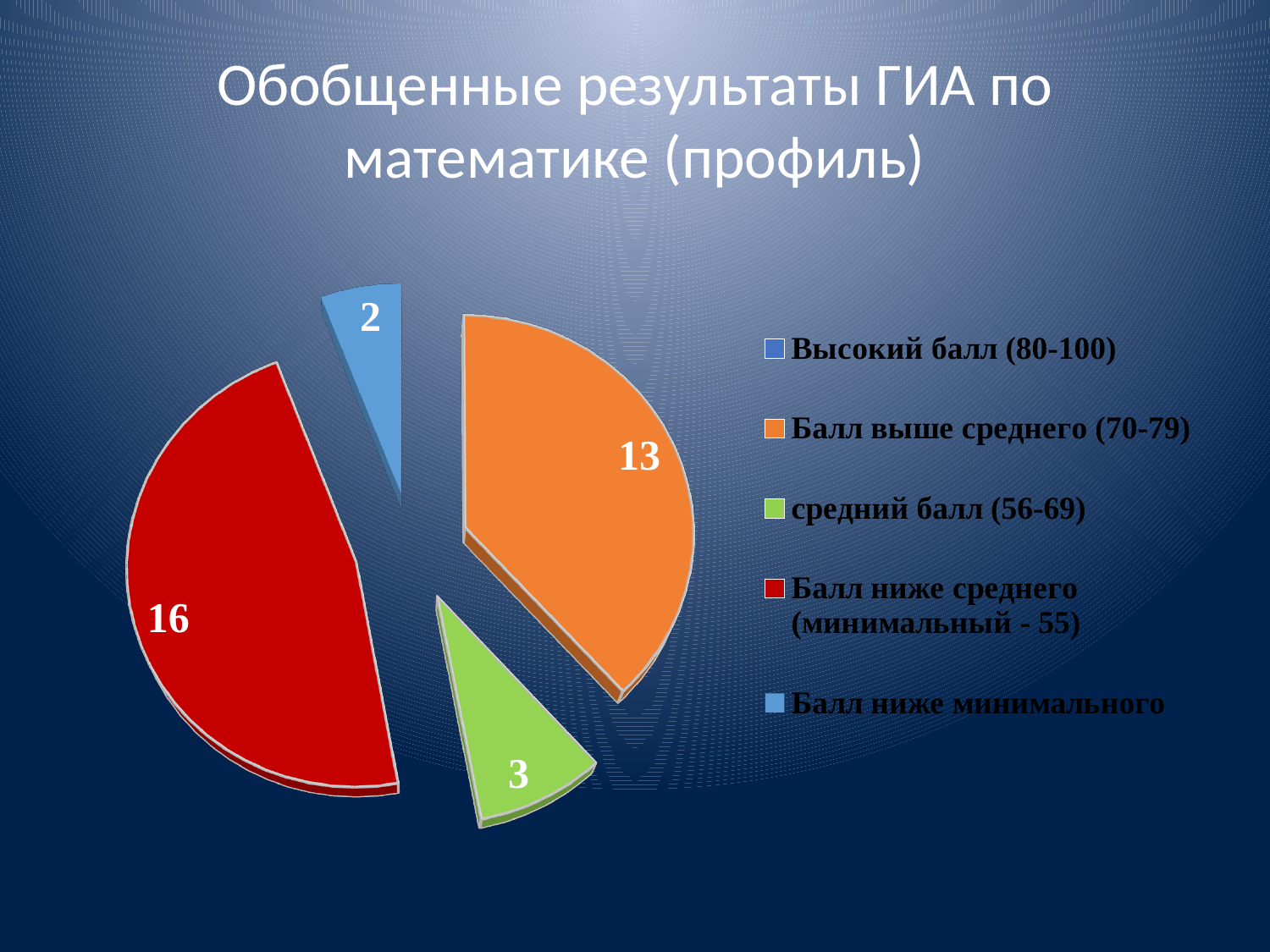
Which is larger: the slice for "Балл выше среднего (70-79)" or the slice for "средний балл (56-69)"? Балл выше среднего (70-79) How many slices with printed data labels are visible in the pie chart? 4 What is the value of the slice for "Балл выше среднего (70-79)"? 13 Which category has the largest slice in the pie chart? Балл ниже среднего (минимальный - 55) What kind of chart is shown on the slide? pie chart What is the title of the slide? Обобщенные результаты ГИА по математике (профиль) What is the difference between the values for "Балл выше среднего (70-79)" and "средний балл (56-69)"? 10 How many entries does the legend list? 5 What is the difference between the values for "Балл ниже среднего (минимальный - 55)" and "Балл выше среднего (70-79)"? 3 What value is printed on the blue slice of the pie? 2 What is the value of the slice for "средний балл (56-69)"? 3 What is the value of the slice for "Балл ниже среднего (минимальный - 55)"? 16